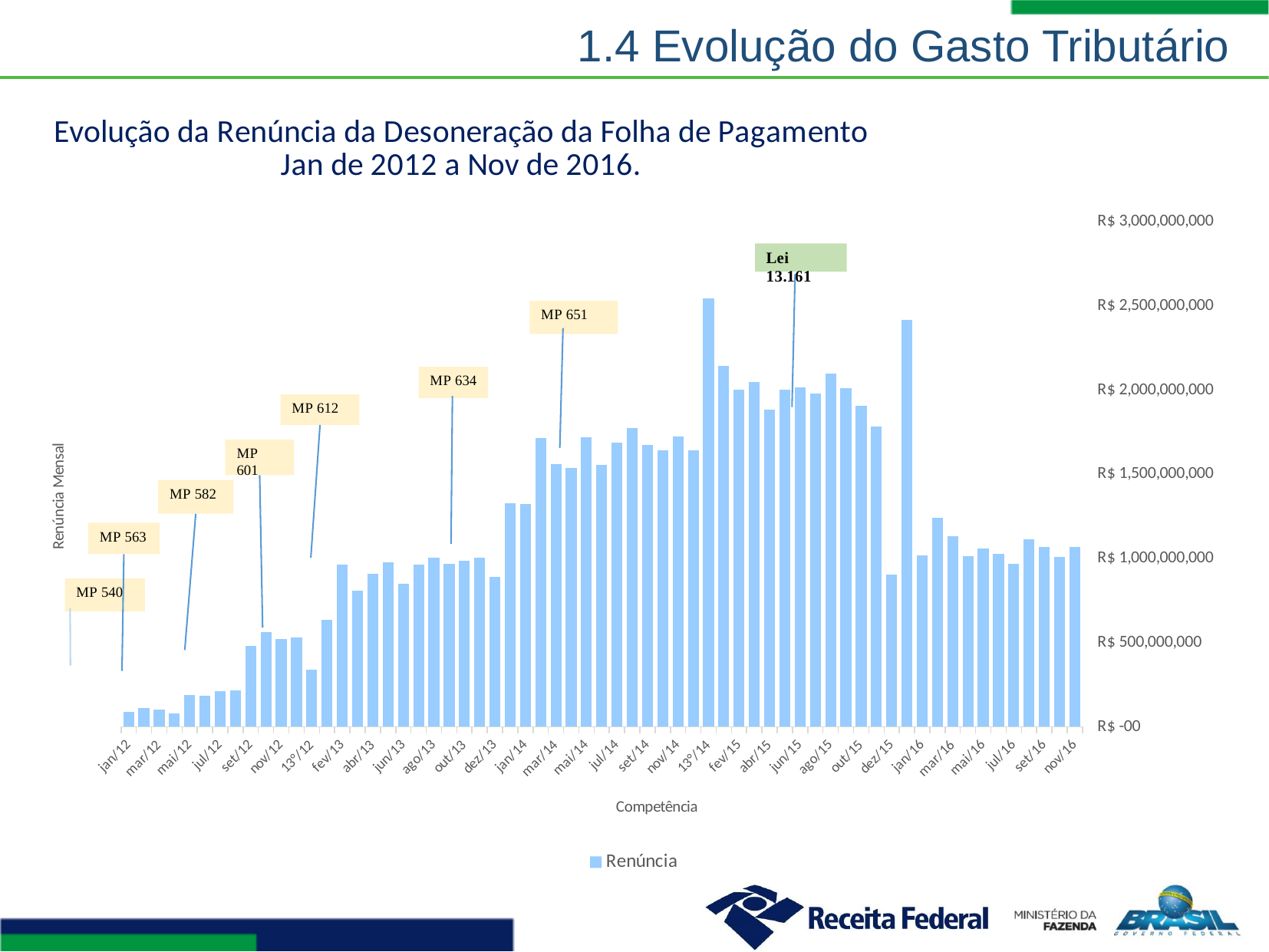
Which month has the highest bar in the chart? 13°/14 Do the values generally rise or fall from jan/12 to jan/14? rise Is the value for dez/15 greater or less than R$ 1,000,000,000? less Which is larger, the value for jan/16 or the value for dez/15? jan/16 Is the value for jan/14 greater or less than R$ 1,000,000,000? greater Is the value for 13°/12 greater or less than R$ 500,000,000? less What is the label of the x axis of the chart? Competência What is the name of the series shown in the chart legend? Renúncia How many series does the chart legend list? 1 What kind of chart is shown on the slide? bar chart